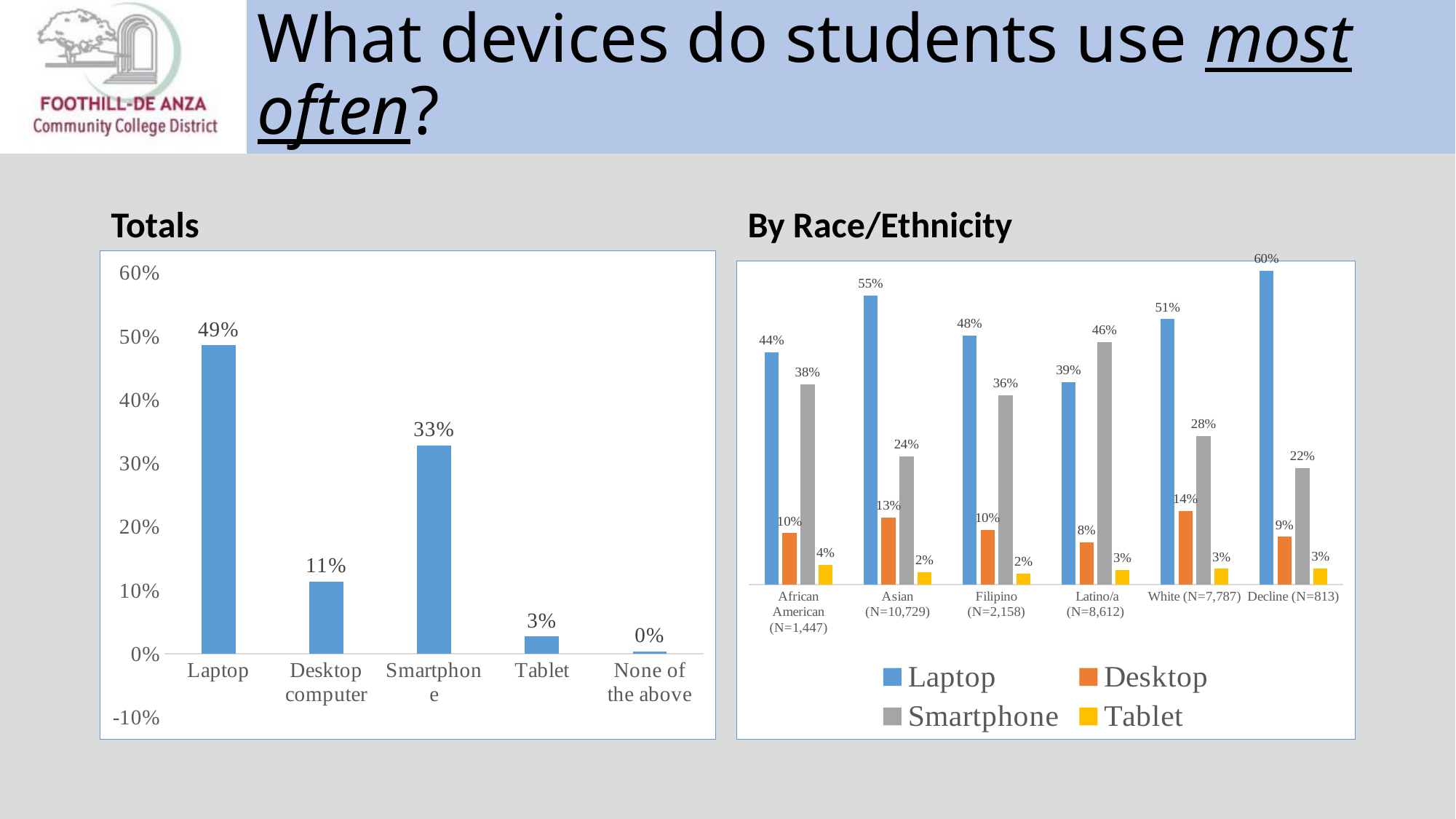
In the Totals chart, how many categories are shown on the x axis? 5 In the Totals chart, what is the difference between the Laptop and Smartphone values? 16% What kind of chart is the By Race/Ethnicity chart? Bar chart In the By Race/Ethnicity chart, how many series does the legend list? 4 In the Totals chart, which device has the highest value? Laptop In the By Race/Ethnicity chart, what is the Laptop value for Asian students? 55% In the By Race/Ethnicity chart, which group has the highest Laptop value? Decline In the Totals chart, what is the value for Tablet? 3% In the By Race/Ethnicity chart, is the Smartphone value larger for Filipino or White students? Filipino In the By Race/Ethnicity chart, which group has the highest Smartphone value? Latino/a In the By Race/Ethnicity chart, what is the difference between the Laptop and Smartphone values for White students? 23% In the Totals chart, what percentage of students use a laptop most often? 49%